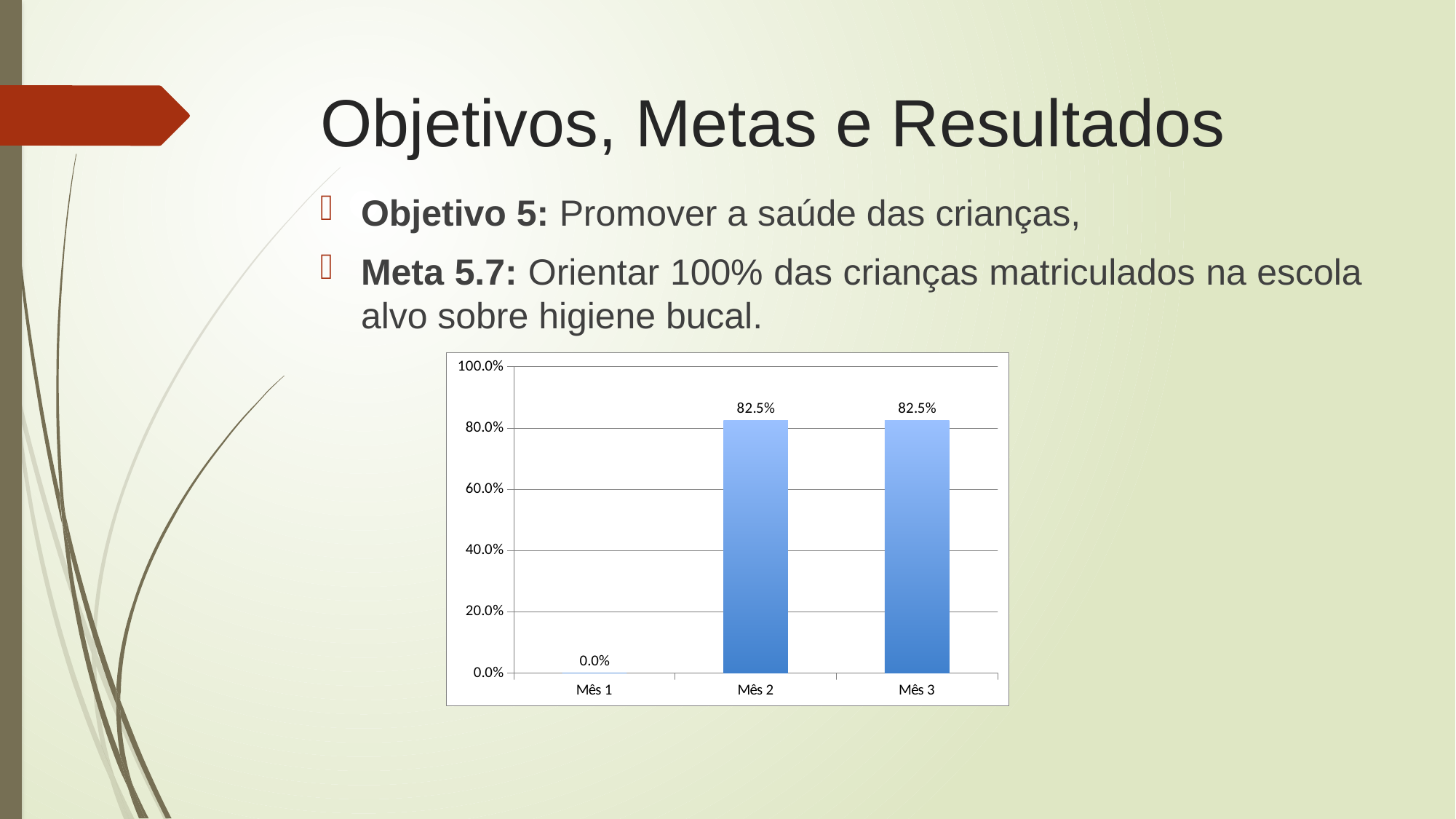
What is the highest tick value shown on the y axis? 100.0% What is the value for Mês 1? 0.0% What kind of chart is shown on the slide? bar chart Which category has the lowest value? Mês 1 How many categories are shown on the x axis? 3 Is the value for Mês 2 greater or less than 80.0%? greater Is the value for Mês 3 greater or less than 100.0%? less Do the values rise or fall from Mês 1 to Mês 2? rise What is the value for Mês 3? 82.5% Which is larger, the value for Mês 1 or the value for Mês 3? Mês 3 What is the difference between the values for Mês 2 and Mês 1? 82.5% What is the value for Mês 2? 82.5%